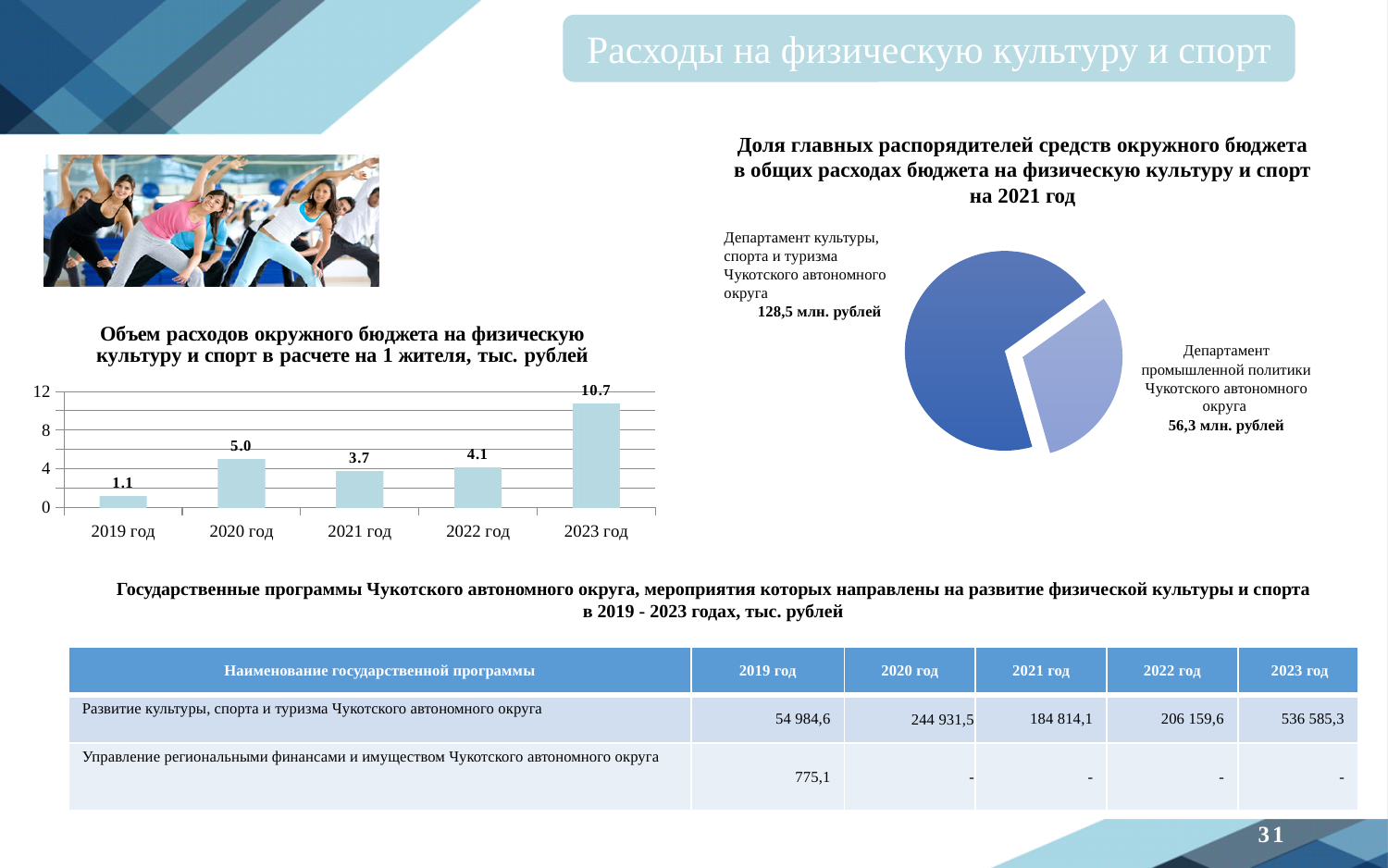
What kind of chart is the chart on the left of the slide? bar chart In the bar chart on the left, which year has the highest value? 2023 год In the bar chart on the left, what is the value for 2023 год? 10.7 In the bar chart on the left, what is the value for 2021 год? 3.7 In the bar chart on the left, what is the value for 2019 год? 1.1 In the bar chart on the left, which year has the lowest value? 2019 год In the pie chart on the right, what is the value for Департамент культуры, спорта и туризма Чукотского автономного округа? 128,5 млн. рублей In the pie chart on the right, which department has the larger slice? Департамент культуры, спорта и туризма Чукотского автономного округа What kind of chart is the chart on the right of the slide? pie chart In the bar chart on the left, how many years are shown on the x axis? 5 In the bar chart on the left, which is larger, the value for 2020 год or 2022 год? 2020 год In the bar chart on the left, what is the difference between the values for 2023 год and 2019 год? 9.6